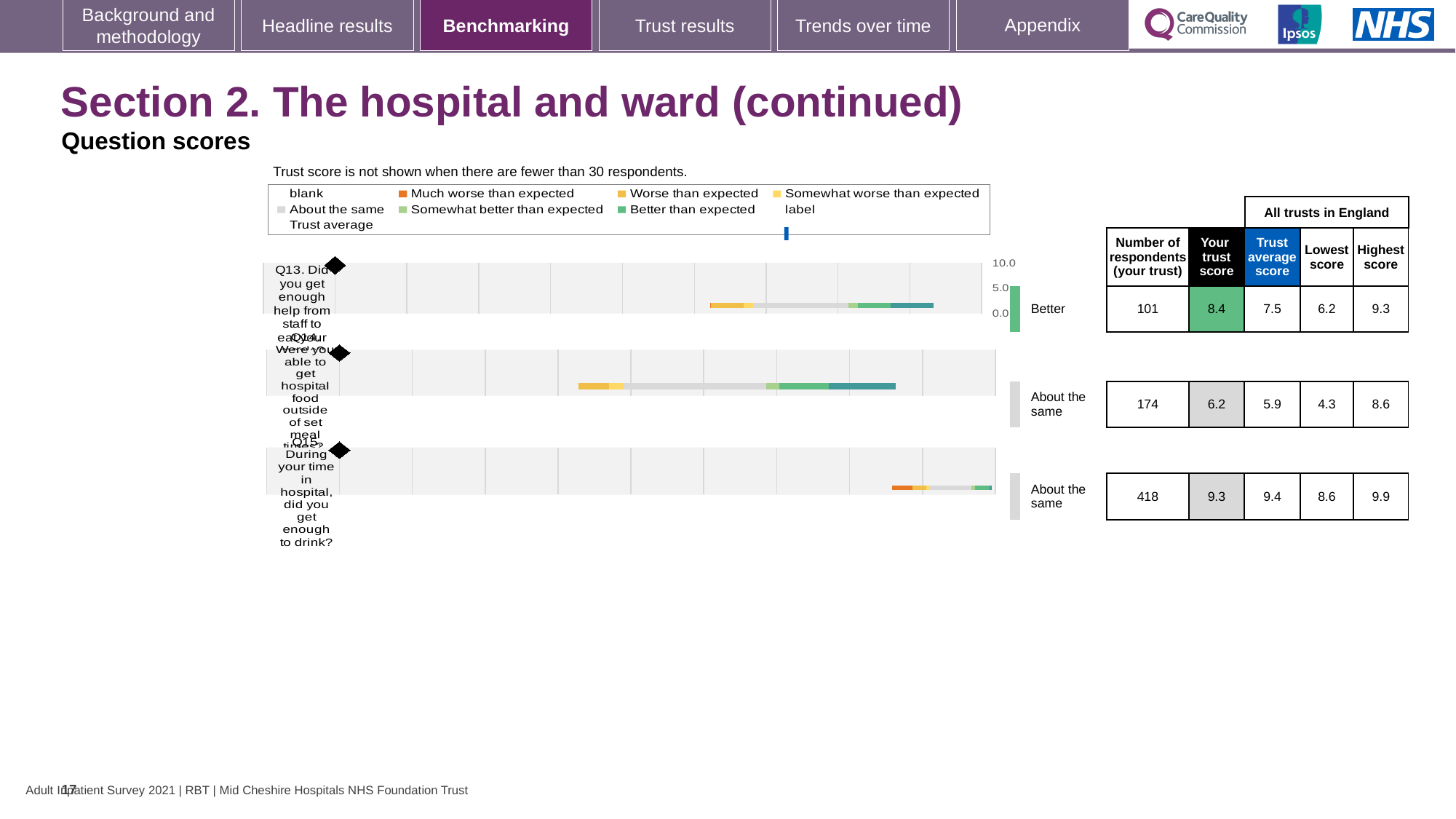
For Q14, which is larger: the trust score or the trust average score? Trust score How many respondents answered Q15 (did you get enough to drink?) at this trust? 418 Which benchmark category is Q13 assigned to? Better Which question has the fewest respondents? Q13 What is the trust average score for Q14 (able to get hospital food outside of set meal times)? 5.9 What kind of chart is used to show the question scores? Bar chart Which question has the highest trust score? Q15 What is the difference between the trust score and the trust average score for Q13? 0.9 What is the highest score across all trusts in England for Q14? 8.6 How many questions are plotted on the chart? 3 For Q15, what is the difference between the highest score and the lowest score across all trusts in England? 1.3 What is the trust score for Q13 (Did you get enough help from staff to eat your meals?)? 8.4